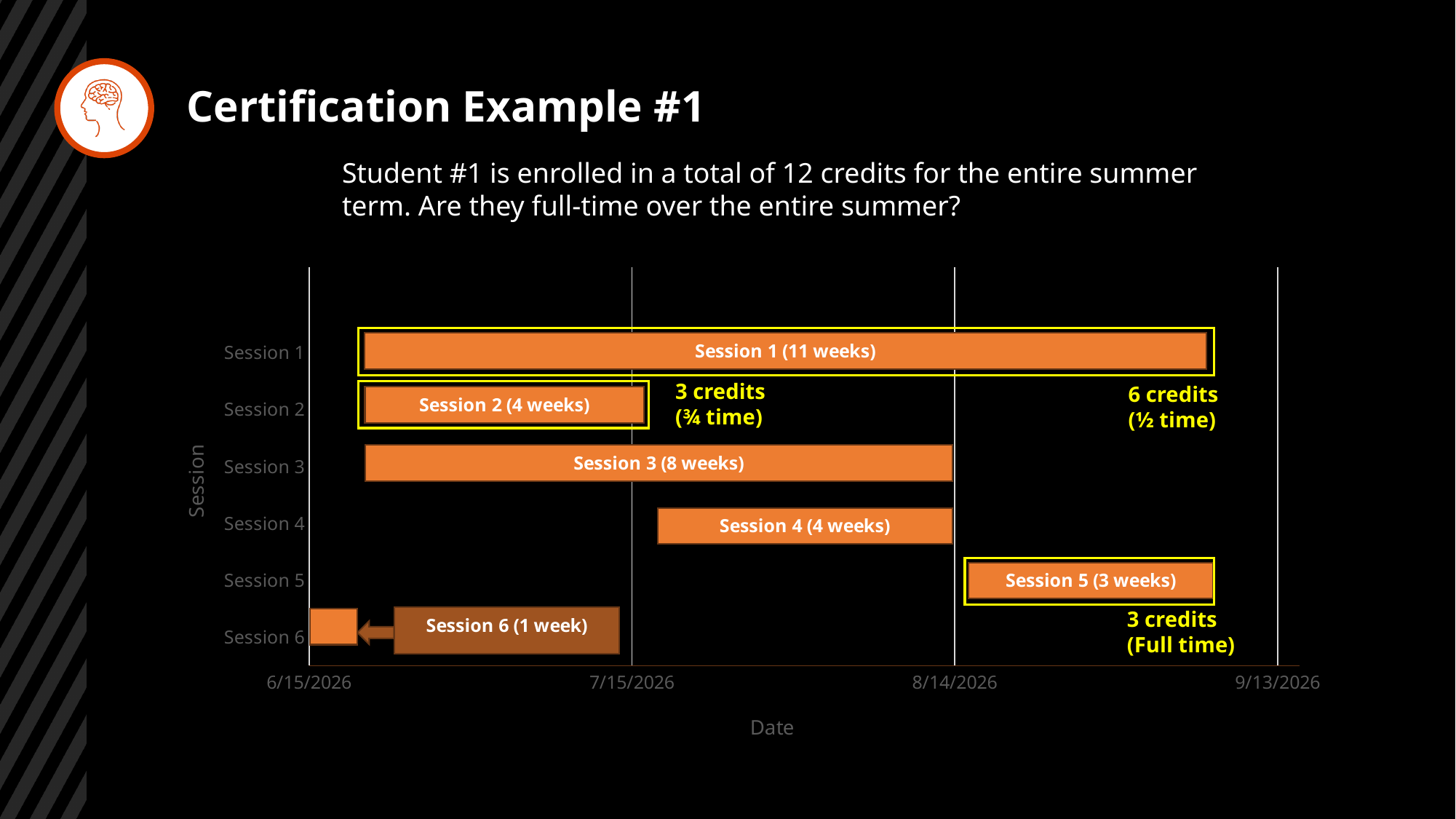
How many weeks long is Session 1 according to its bar label? 11 weeks Which session has the shortest bar on the chart? Session 6 How many sessions are listed on the vertical axis of the chart? 6 Which is longer, Session 2 or Session 5? Session 2 How many weeks long is Session 3 according to its bar label? 8 weeks Which session has the longest bar on the chart? Session 1 How long is Session 6 according to its bar label? 1 week What kind of chart is shown on the slide? Bar chart How many weeks longer is Session 1 than Session 3? 3 weeks What is the label of the horizontal axis of the chart? Date How many weeks long is Session 5 according to its bar label? 3 weeks How many weeks longer is Session 3 than Session 4? 4 weeks